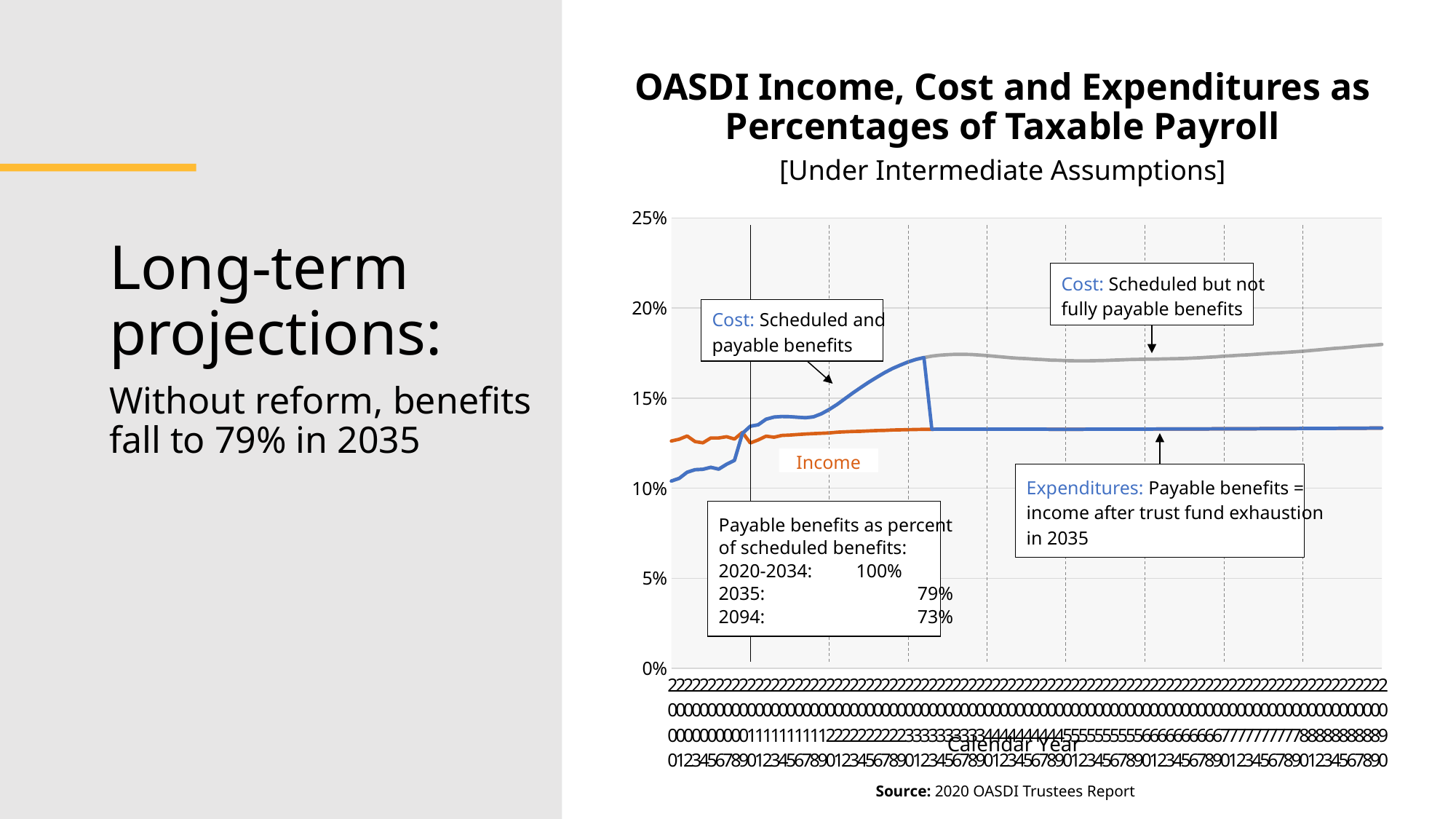
According to the annotation on the chart, what are payable benefits as a percent of scheduled benefits in 2035? 79% Is the Income value in 2000 greater or less than 15%? less In 2090, which is higher: the Cost line or the Expenditures line? Cost Is the Cost (scheduled but not fully payable benefits) value in 2090 greater or less than 15%? greater Does the Cost line rise or fall between 2010 and 2035? rise What is the title of the chart? OASDI Income, Cost and Expenditures as Percentages of Taxable Payroll What kind of chart is shown on the slide? line chart What is the label of the x axis of the chart? Calendar Year Is the Income value in 2000 greater or less than 10%? greater According to the annotation on the chart, what are payable benefits as a percent of scheduled benefits in 2094? 73%